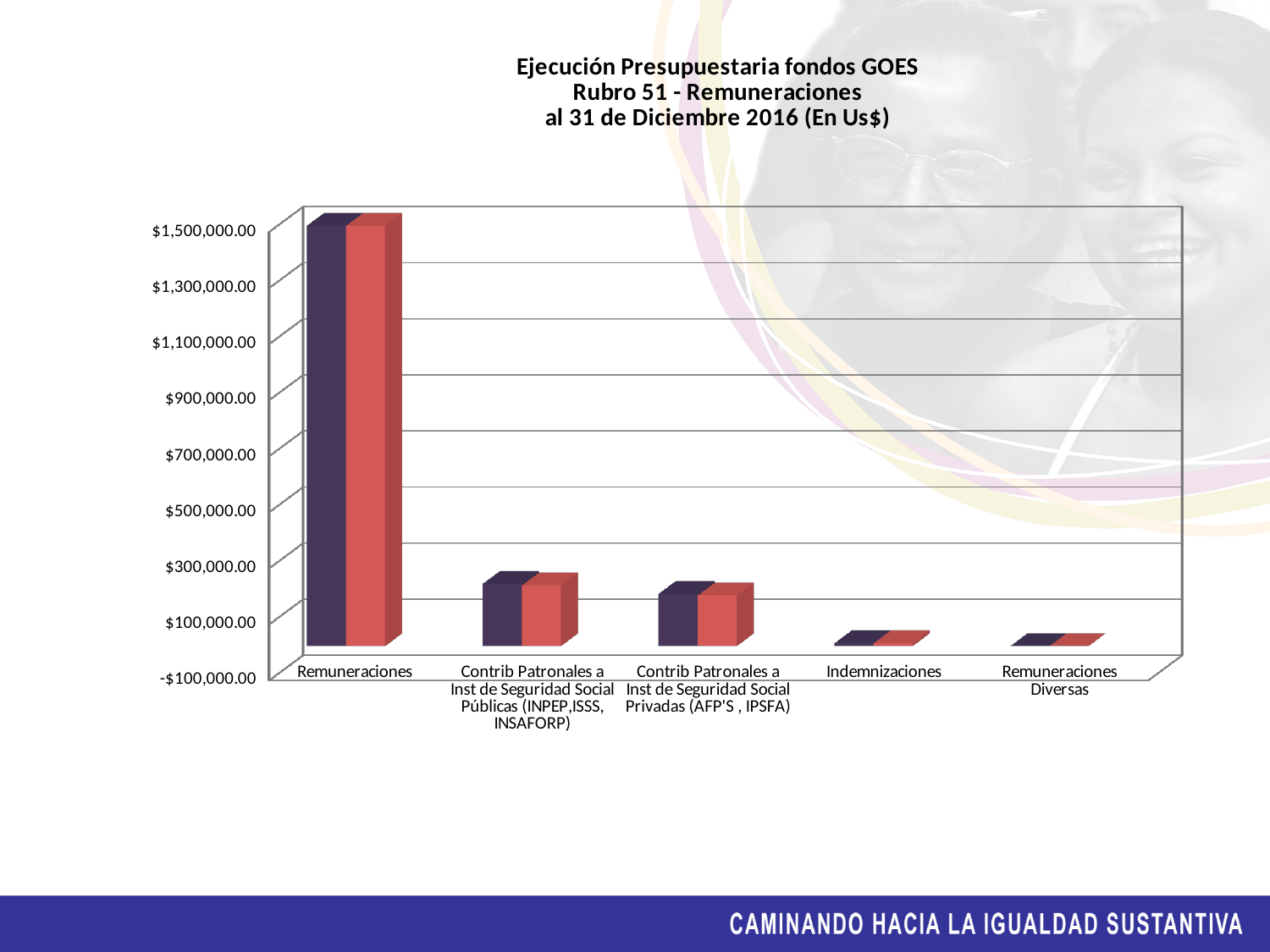
How many categories are shown on the x axis of the chart? 5 What is the title of the chart? Ejecución Presupuestaria fondos GOES Rubro 51 - Remuneraciones al 31 de Diciembre 2016 (En Us$) Is the value for Contrib Patronales a Inst de Seguridad Social Privadas (AFP'S , IPSFA) greater or less than $500,000.00? less Is the value for Contrib Patronales a Inst de Seguridad Social Públicas (INPEP,ISSS, INSAFORP) greater or less than $300,000.00? less What kind of chart is shown on the slide? bar chart Is the value for Remuneraciones greater or less than $1,300,000.00? greater Which is larger, the value for Remuneraciones or the value for Indemnizaciones? Remuneraciones Which category has the highest values in the chart? Remuneraciones Which is larger, the value for Contrib Patronales a Inst de Seguridad Social Públicas (INPEP,ISSS, INSAFORP) or the value for Remuneraciones Diversas? Contrib Patronales a Inst de Seguridad Social Públicas (INPEP,ISSS, INSAFORP) Do the values generally rise or fall moving from left to right across the categories? fall